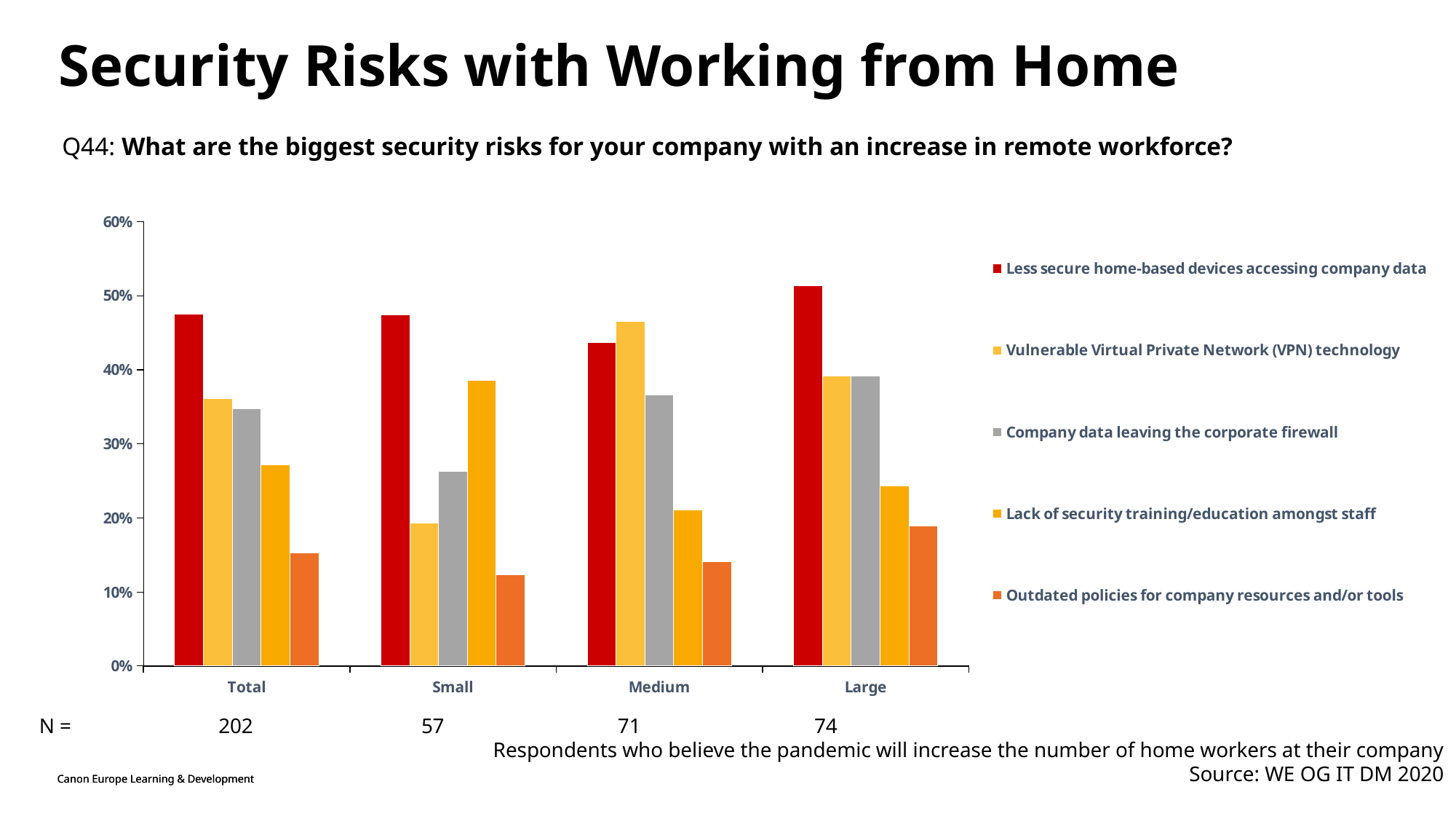
Is the value for 'Outdated policies for company resources and/or tools' in the Small category greater or less than 20%? less How many series does the legend list? 5 How many company-size categories are shown on the x axis? 4 Which category has the highest bar for 'Less secure home-based devices accessing company data'? Large In the Small category, which security risk has the highest bar? Less secure home-based devices accessing company data In the Small category, which is larger: 'Lack of security training/education amongst staff' or 'Company data leaving the corporate firewall'? Lack of security training/education amongst staff What is the N (number of respondents) shown for the Medium category? 71 Is the value for 'Less secure home-based devices accessing company data' in the Large category greater or less than 40%? greater What kind of chart is shown on the slide? bar chart Which category has the lowest bar for 'Vulnerable Virtual Private Network (VPN) technology'? Small In the Total category, which security risk has the lowest bar? Outdated policies for company resources and/or tools In the Medium category, which is larger: 'Vulnerable Virtual Private Network (VPN) technology' or 'Less secure home-based devices accessing company data'? Vulnerable Virtual Private Network (VPN) technology